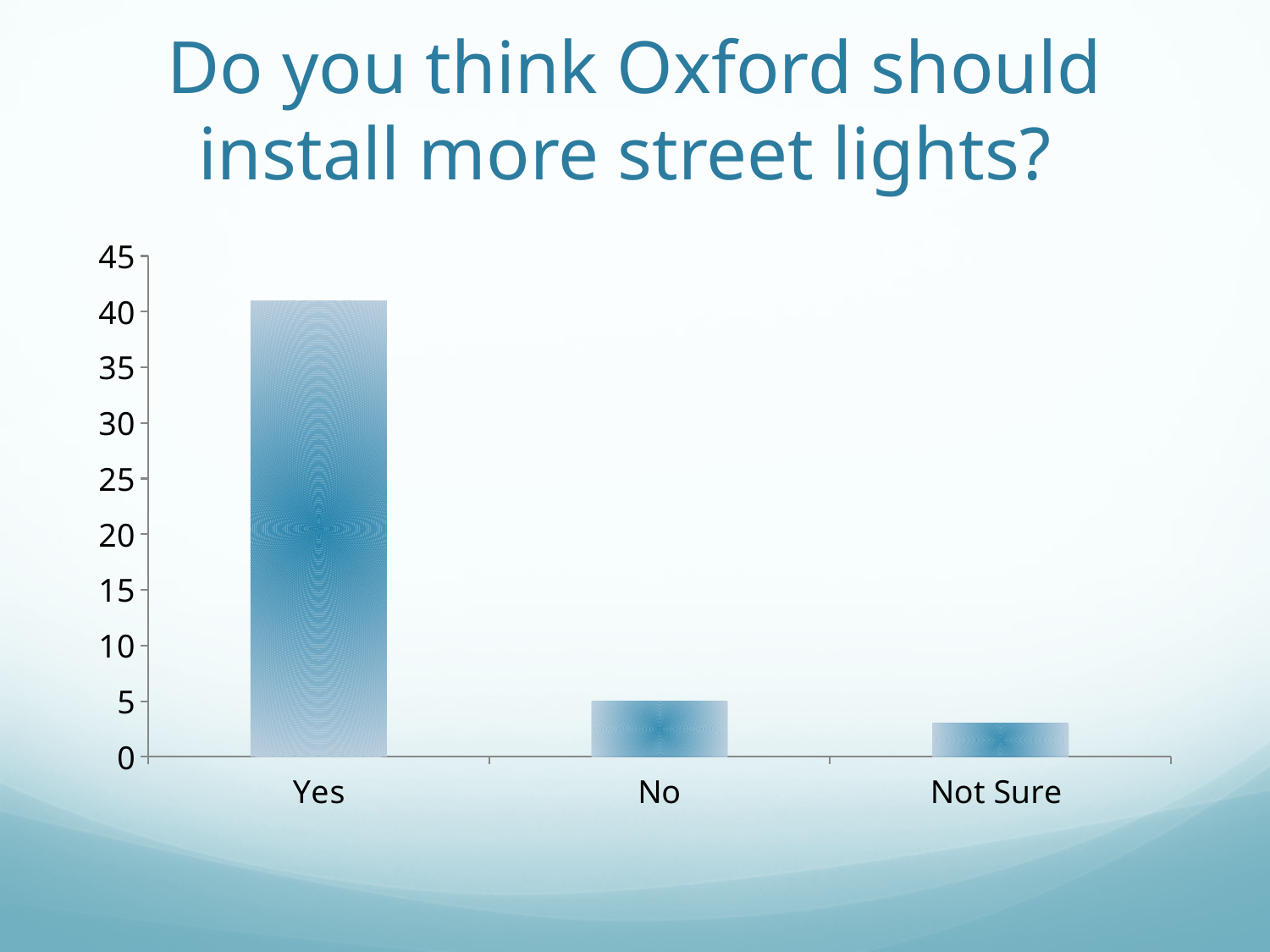
What is the value for No in the chart? 5 What kind of chart is shown on the slide? bar chart Which is larger, the value for No or the value for Not Sure? No Which category has the highest value in the chart? Yes Is the value for Not Sure greater or less than 5? less Which category has the lowest value in the chart? Not Sure How many categories are shown on the x axis of the chart? 3 Which is larger, the value for Yes or the value for No? Yes Is the value for Yes greater or less than 45? less Is the value for Yes greater or less than 35? greater What is the highest value shown on the vertical axis of the chart? 45 What is the title of the chart on the slide? Do you think Oxford should install more street lights?